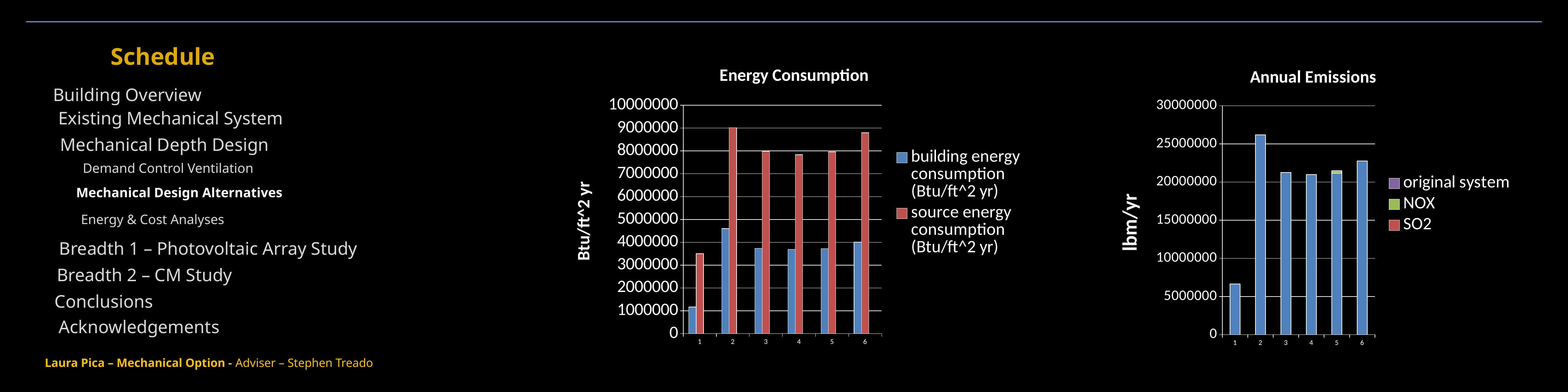
On the Energy Consumption chart, which is larger: the building energy consumption for category 2 or for category 3? category 2 On the Energy Consumption chart, is the building energy consumption for category 1 greater or less than 2000000? less On the Energy Consumption chart, is the source energy consumption for category 2 greater or less than 8000000? greater On the Annual Emissions chart, is the value for category 1 greater or less than 10000000? less On the Energy Consumption chart, which category has the highest source energy consumption? 2 On the Annual Emissions chart, which category has the tallest bar? 2 On the Energy Consumption chart, what kind of chart is shown? bar chart On the Energy Consumption chart, how many categories are shown on the x axis? 6 On the Annual Emissions chart, what is the label on the y axis? lbm/yr On the Energy Consumption chart, how many series does the legend list? 2 On the Energy Consumption chart, which category has the lowest building energy consumption? 1 On the Annual Emissions chart, how many series does the legend list? 3